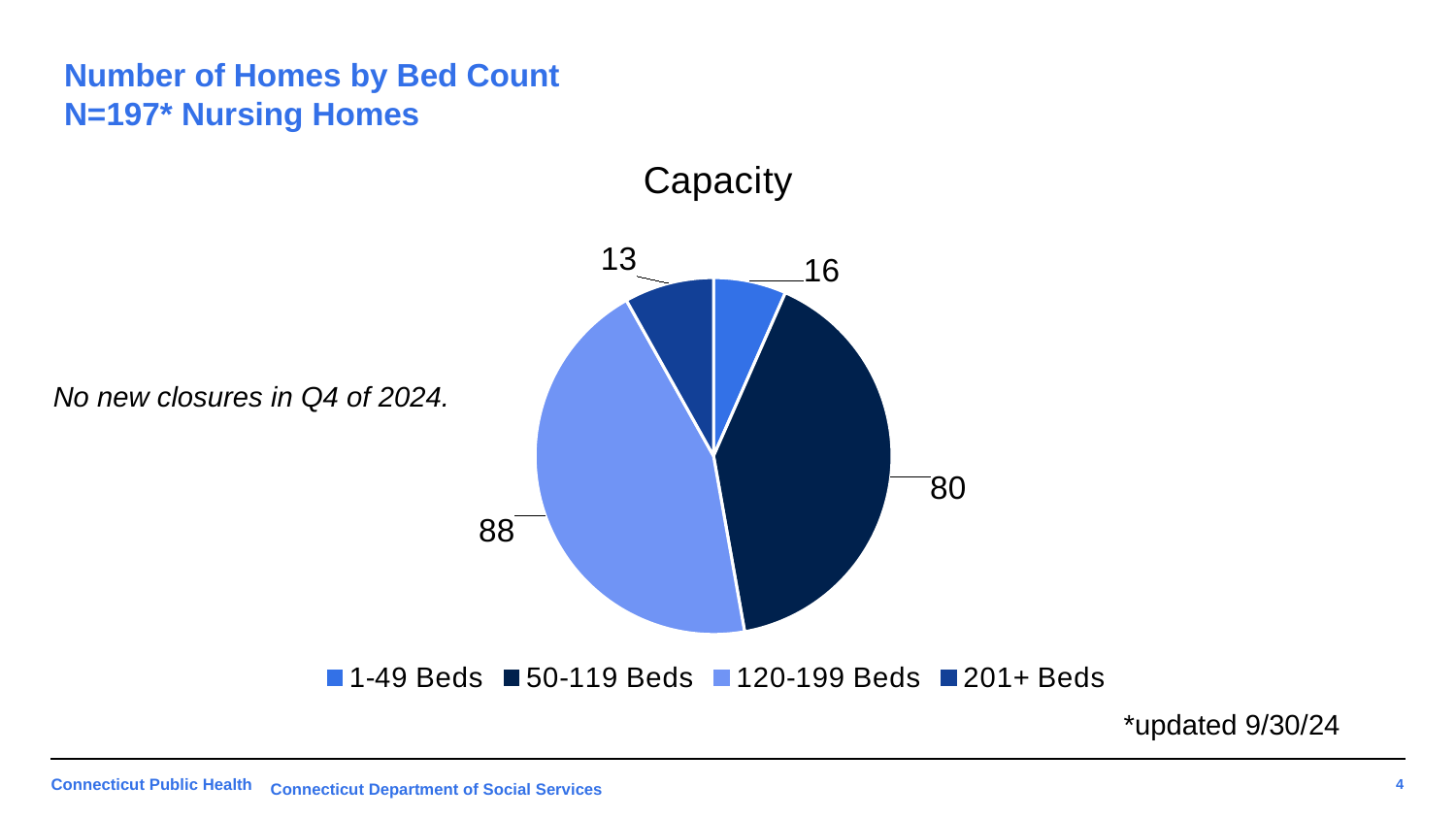
How many homes have 201+ beds? 13 What is the title of the chart? Capacity How many slices does the pie chart have? 4 What type of chart is shown on the slide? pie chart How many homes have 50-119 beds? 80 How many homes have 1-49 beds? 16 Which bed-count category has the most homes? 120-199 Beds Which category has more homes: 1-49 Beds or 201+ Beds? 1-49 Beds How many categories does the legend list? 4 What is the difference between the number of homes with 120-199 beds and those with 50-119 beds? 8 How many homes have 120-199 beds? 88 Which bed-count category has the fewest homes? 201+ Beds